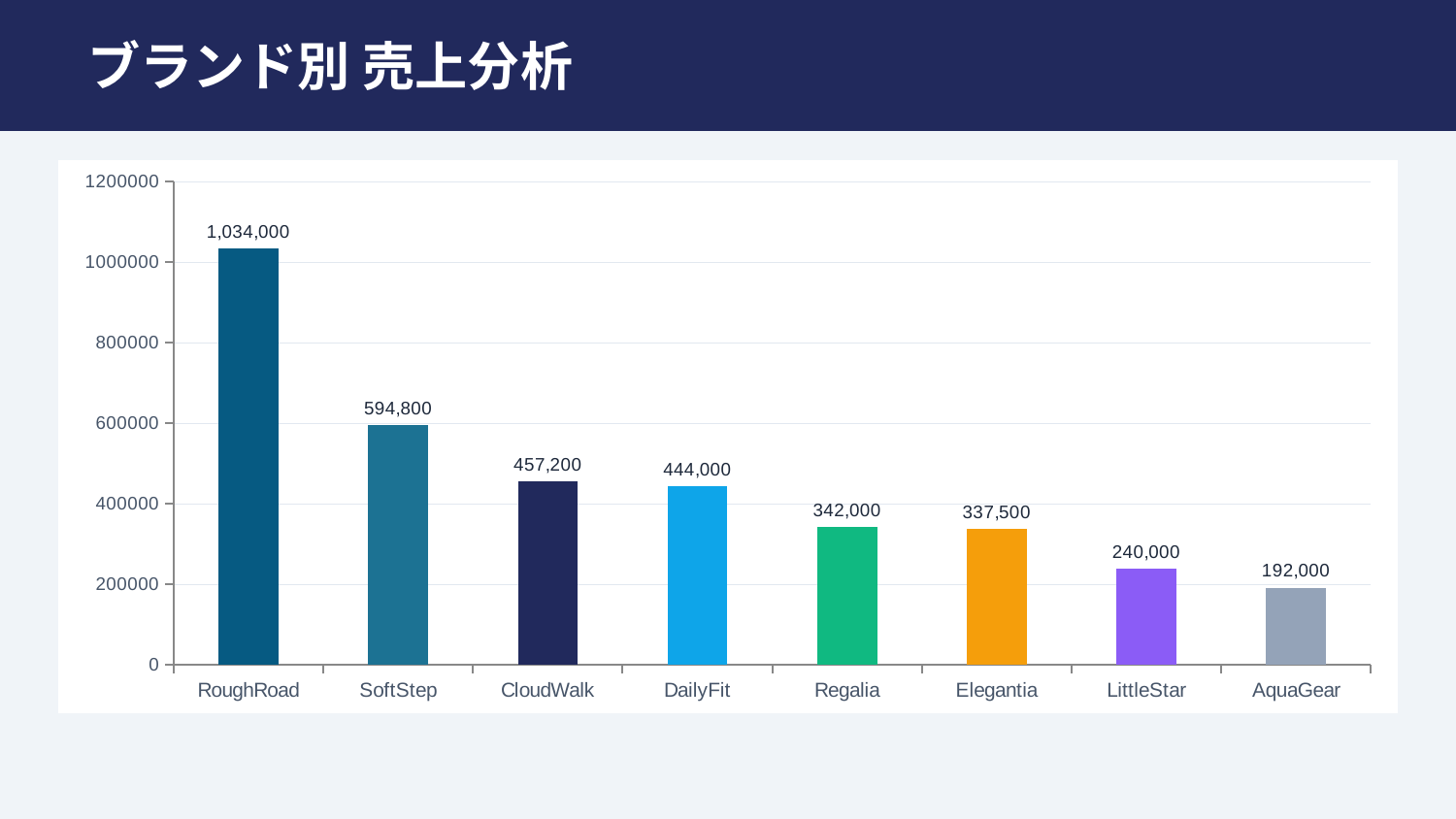
Which brand has the highest value? RoughRoad Which is larger, the value for DailyFit or the value for Elegantia? DailyFit What is the value for Regalia? 342,000 How many brands are shown on the chart? 8 What is the title of the slide? ブランド別 売上分析 Is the value for CloudWalk greater or less than 400000? greater Which brand has the lowest value? AquaGear What kind of chart is shown on the slide? bar chart What is the difference between the values for LittleStar and AquaGear? 48,000 What is the value for RoughRoad? 1,034,000 What is the value for AquaGear? 192,000 What is the difference between the values for SoftStep and CloudWalk? 137,600